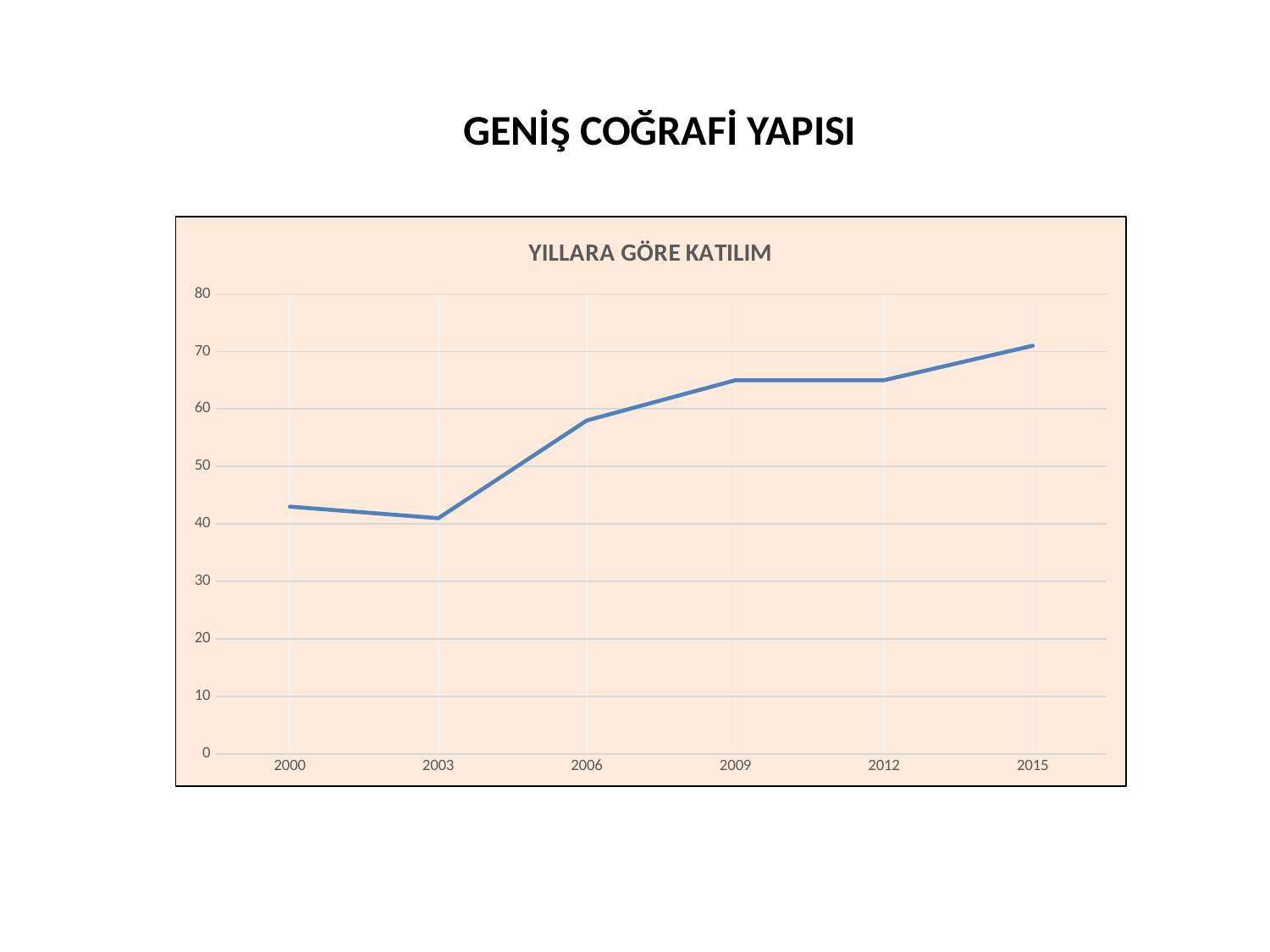
How many years are plotted on the x axis of the chart? 6 Is the value for 2009 greater or less than 60? greater Is the value for 2015 greater or less than 80? less Which year has the lowest value in the chart? 2003 Which year has the highest value in the chart? 2015 What kind of chart is shown on the slide? line chart Which is larger, the value for 2006 or the value for 2003? 2006 What is the title of the chart? YILLARA GÖRE KATILIM Is the value for 2006 greater or less than 50? greater Do the values generally rise or fall from 2003 to 2015? rise